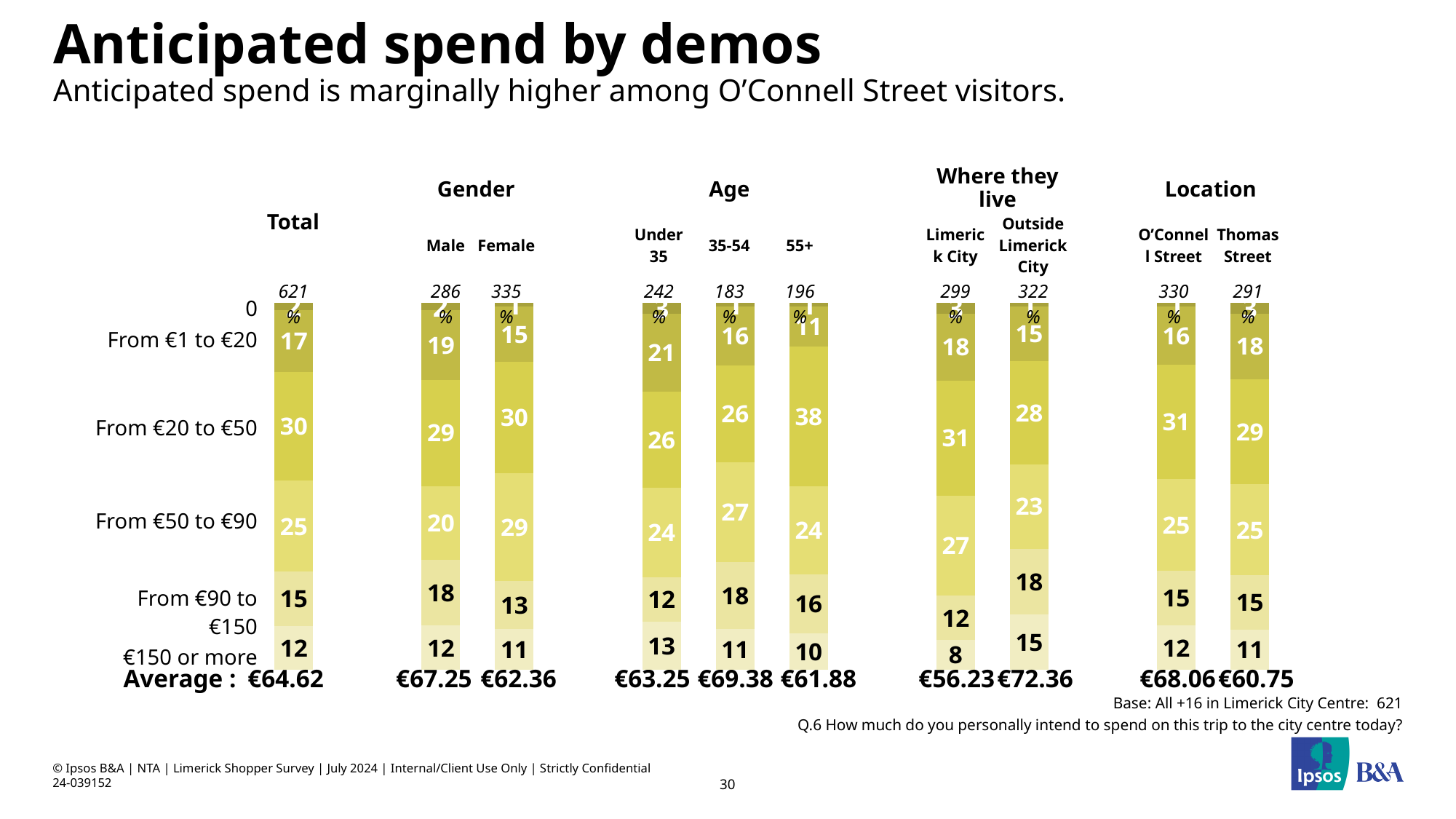
What type of chart is used on this slide? Stacked bar chart What is the difference between the average anticipated spend of O'Connell Street and Thomas Street visitors? €7.31 What is the average anticipated spend for the 35-54 age group? €69.38 What percentage of the Total group anticipate spending from €20 to €50? 30 Which demographic group has the lowest average anticipated spend? Limerick City How many demographic bars are shown on the slide in total? 10 What percentage of 55+ respondents anticipate spending from €20 to €50? 38 Which demographic group has the highest average anticipated spend? Outside Limerick City What is the base size (number of respondents) for the Under 35 group? 242 What percentage of Limerick City respondents anticipate spending €150 or more? 8 What is the average anticipated spend for Outside Limerick City respondents? €72.36 Which is larger: the percentage of Male respondents spending from €50 to €90 or the percentage of Female respondents spending from €50 to €90? Female